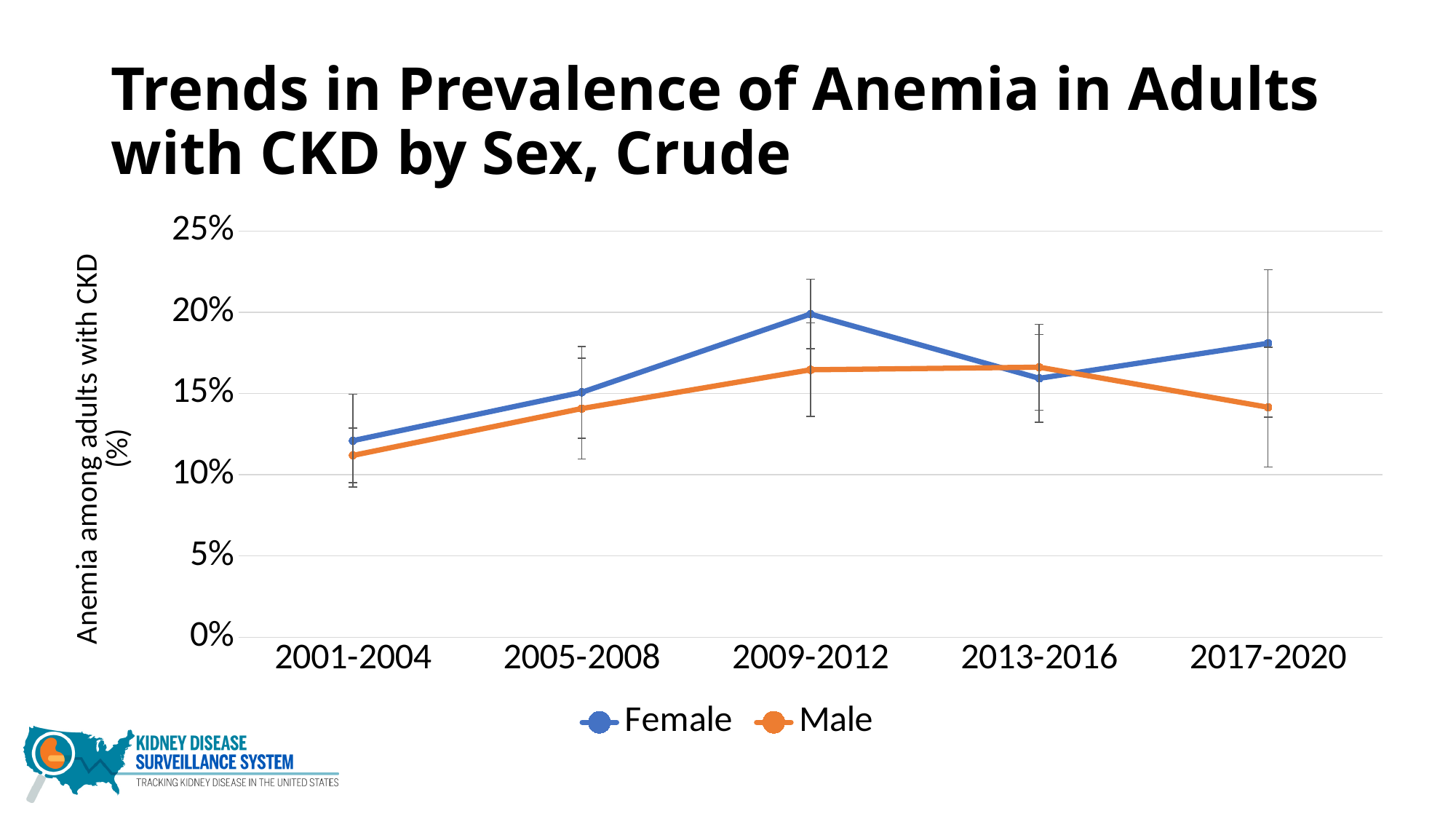
Is the Male value for 2001-2004 greater or less than 15%? less In which period is the Female prevalence of anemia highest? 2009-2012 In 2017-2020, which series has the higher prevalence, Female or Male? Female Does the Male prevalence rise or fall from 2001-2004 to 2009-2012? rise In which period is the Female prevalence of anemia lowest? 2001-2004 What is the title of the chart's y axis? Anemia among adults with CKD (%) In 2009-2012, which series has the higher prevalence, Female or Male? Female Is the Female value for 2009-2012 greater or less than 15%? greater In which period is the Male prevalence of anemia lowest? 2001-2004 How many series does the legend list? 2 How many time periods are shown on the x axis? 5 What kind of chart is shown on the slide? line chart